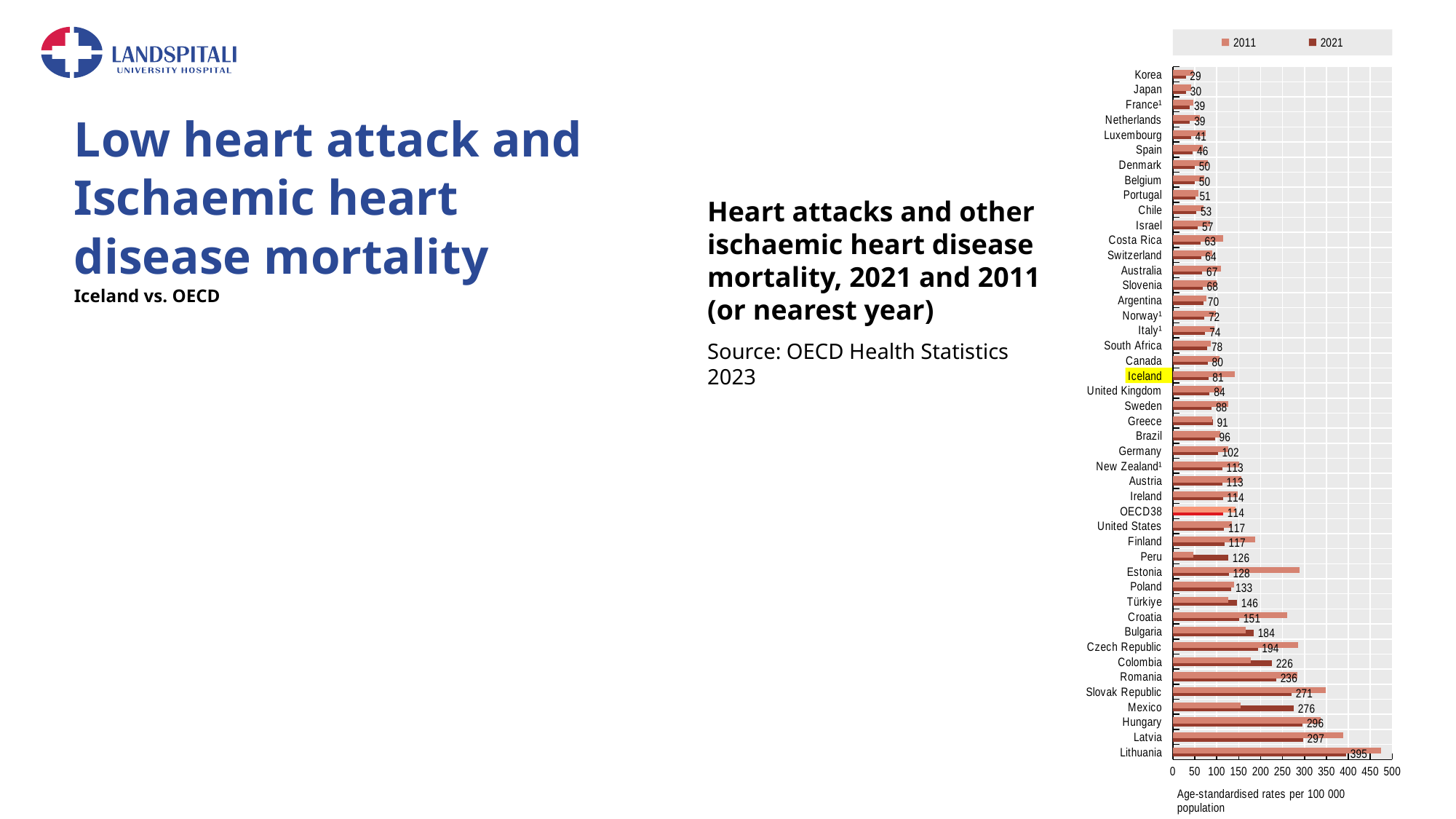
Which country label is highlighted in yellow on the chart? Iceland How many series does the legend list? 2 What is the 2021 value for Iceland? 81 Which country has the lowest 2021 value? Korea What is the difference between the 2021 values for Lithuania and Latvia? 98 Which has the larger 2021 value, Mexico or Hungary? Hungary What kind of chart is shown on the slide? Bar chart What is the difference between the 2021 values for OECD38 and Iceland? 33 Is the 2011 value for Lithuania greater or less than 450? greater Which country has the highest 2021 value? Lithuania What is the 2021 value for OECD38? 114 What is the 2021 value for Lithuania? 395